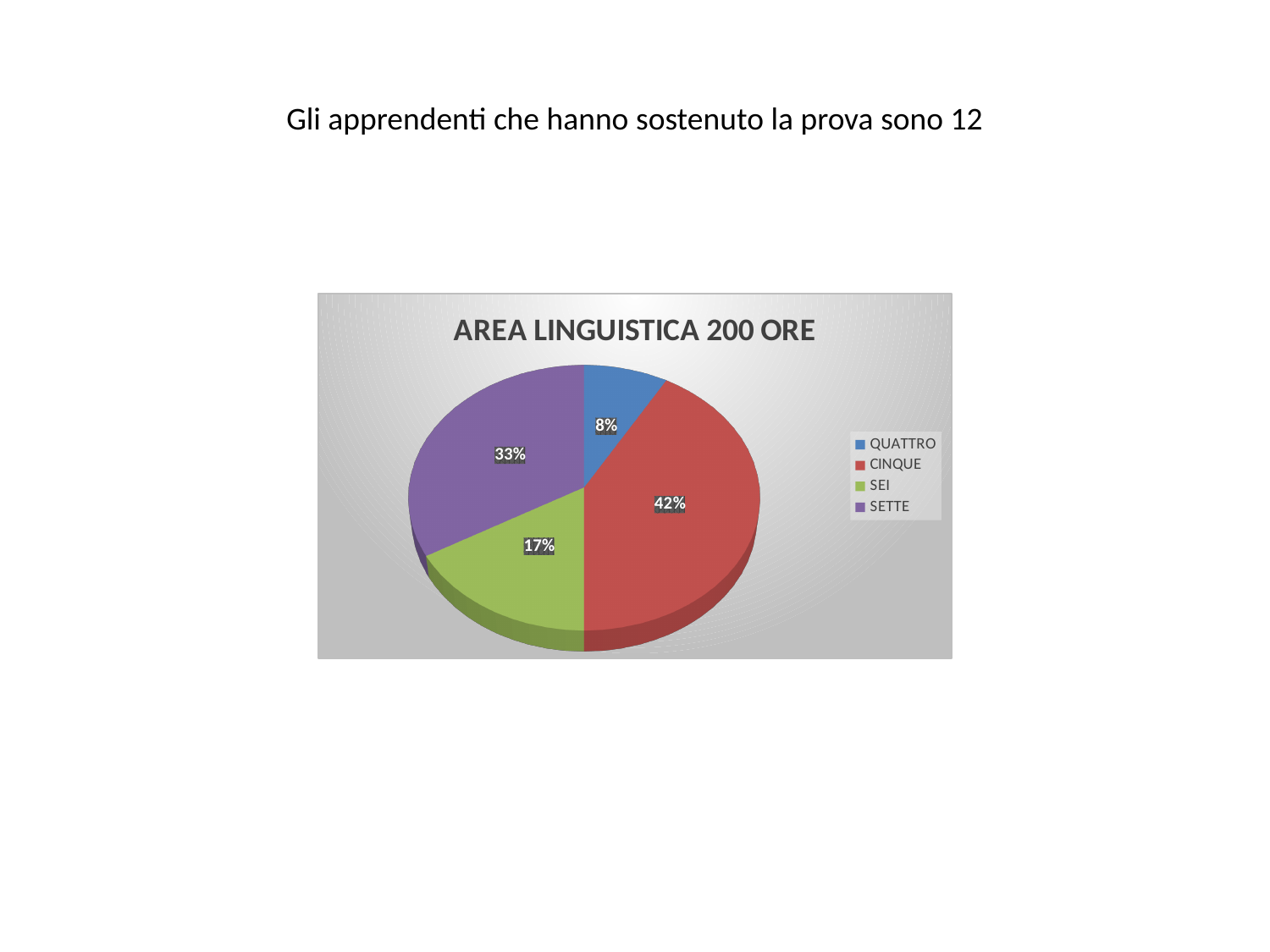
How many categories does the legend list? 4 What is the title of the chart? AREA LINGUISTICA 200 ORE What is the difference in percentage points between the CINQUE slice and the SETTE slice? 9 What percentage of the pie does the SEI slice represent? 17% What percentage of the pie does the QUATTRO slice represent? 8% Which category has the largest slice of the pie? CINQUE Which category has the smallest slice of the pie? QUATTRO What percentage of the pie does the CINQUE slice represent? 42% What type of chart is shown on the slide? Pie chart Which slice is larger, SEI or SETTE? SETTE What colour is the SETTE slice in the pie chart? Purple